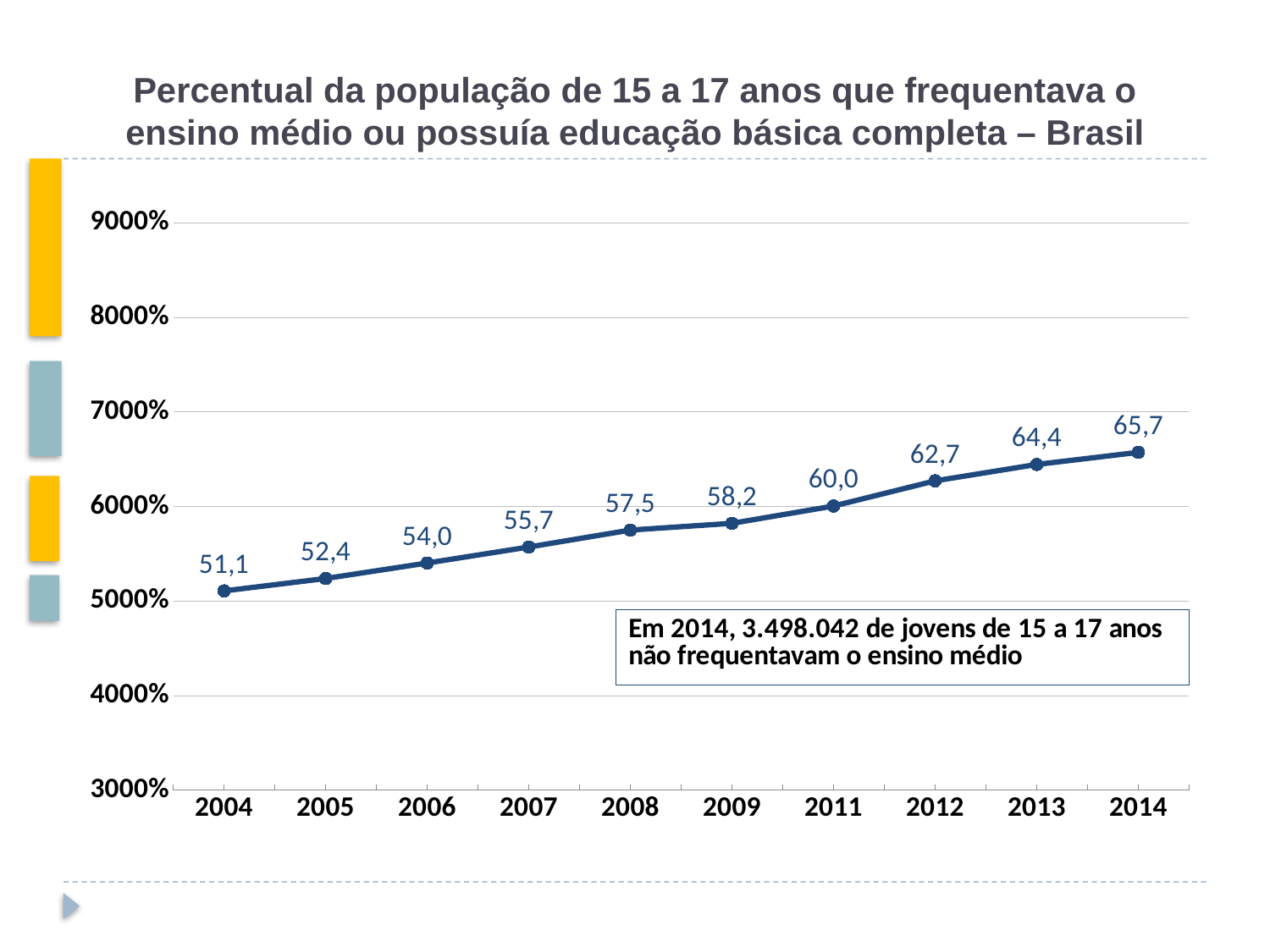
Which is larger, the value for 2008 or the value for 2012? 2012 What value is shown for 2009? 58,2 What value is shown for 2004? 51,1 How many years are plotted on the chart? 10 Do the values rise or fall from 2004 to 2014? Rise Which year has the highest value? 2014 What value is shown for 2011? 60,0 What is the difference between the values for 2013 and 2012? 1,7 What value is shown for 2014? 65,7 What kind of chart is shown on the slide? Line chart What is the difference between the values for 2014 and 2004? 14,6 Which year has the lowest value? 2004